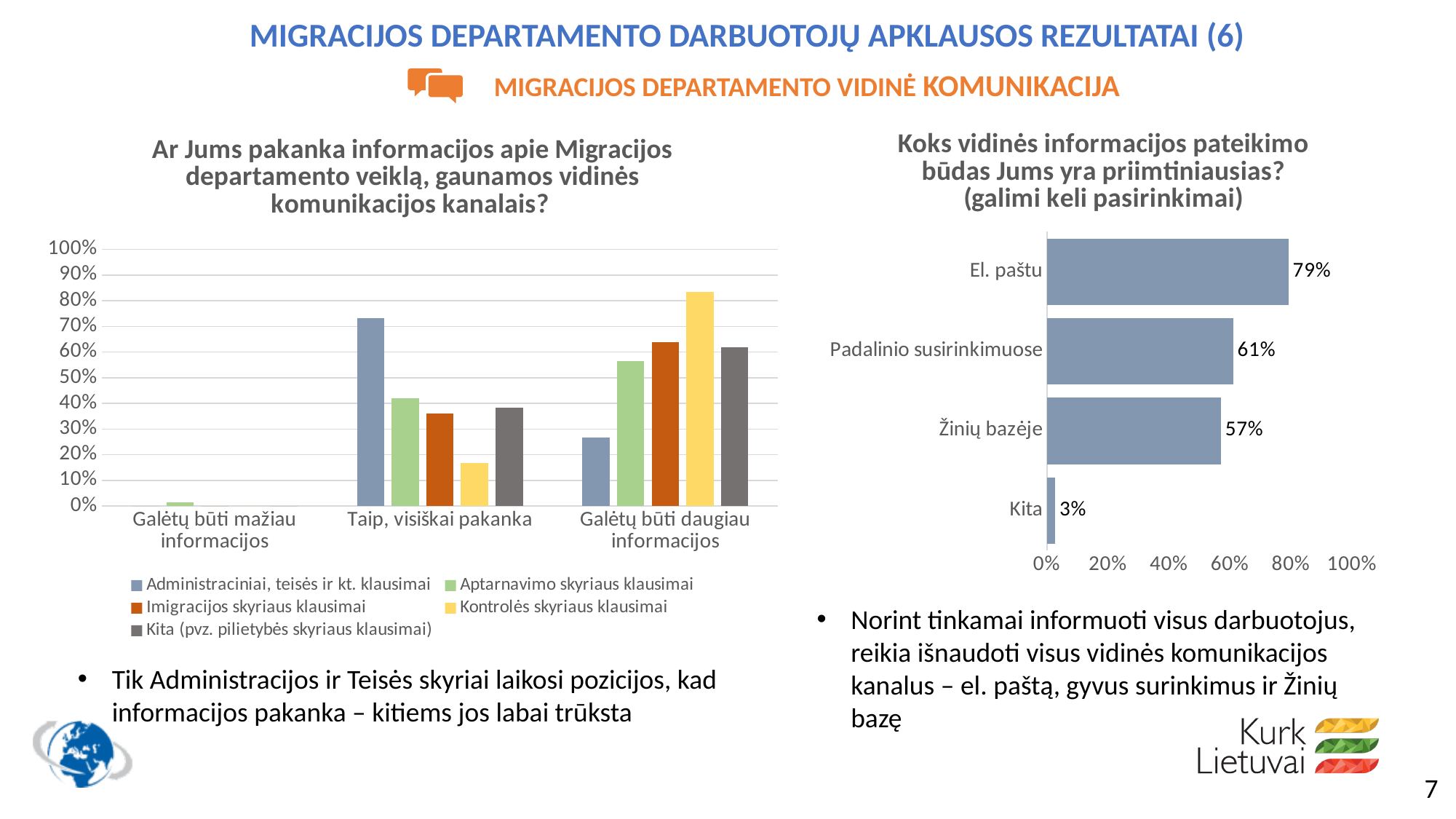
In the left chart, is the value for Administraciniai, teisės ir kt. klausimai in the category 'Taip, visiškai pakanka' greater or less than 60%? greater How many series does the legend of the left chart list? 5 In the right chart, what is the difference between the values for El. paštu and Padalinio susirinkimuose? 18 percentage points In the right chart, what is the value for Žinių bazėje? 57% How many categories are shown on the x axis of the left chart? 3 In the left chart, which series has the highest value in the category 'Galėtų būti daugiau informacijos'? Kontrolės skyriaus klausimai In the right chart, what is the value for Padalinio susirinkimuose? 61% In the right chart, which category has the lowest value? Kita What kind of chart is the right chart? Bar chart In the right chart (Koks vidinės informacijos pateikimo būdas Jums yra priimtiniausias?), what is the value for El. paštu? 79% How many categories are shown in the right chart? 4 In the right chart, which category has the highest value? El. paštu